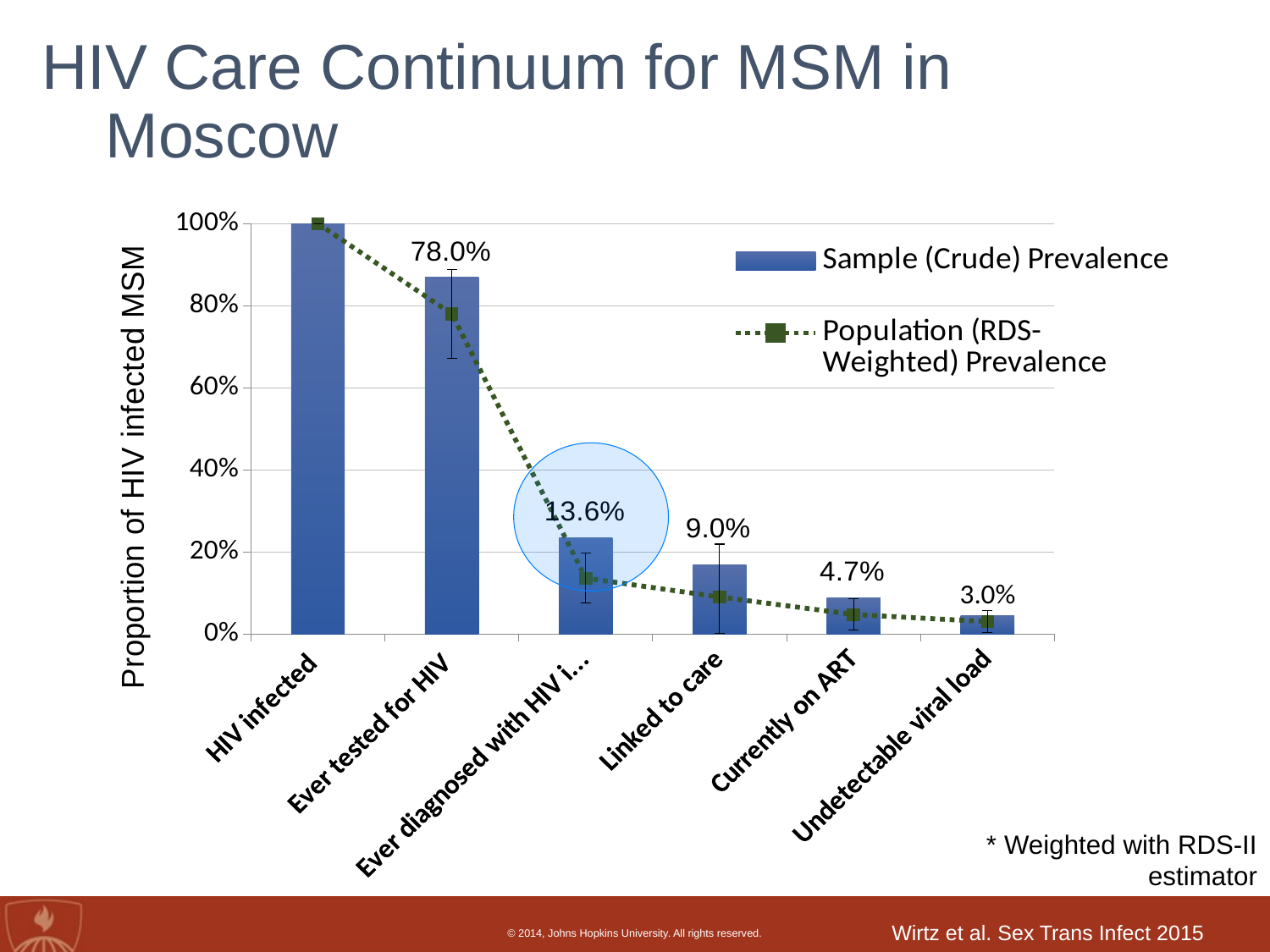
Which category has the highest Sample (Crude) Prevalence? HIV infected What is the Population (RDS-Weighted) Prevalence value for Linked to care? 9.0% What is the Population (RDS-Weighted) Prevalence value for Currently on ART? 4.7% Is the Sample (Crude) Prevalence bar for Linked to care greater or less than 20%? less How many series does the legend list? 2 Which category has the lowest Population (RDS-Weighted) Prevalence? Undetectable viral load How many categories are shown on the x axis? 6 What is the Population (RDS-Weighted) Prevalence value for Undetectable viral load? 3.0% Do the values rise or fall moving from left to right along the x axis? fall What is the Population (RDS-Weighted) Prevalence value for Ever tested for HIV? 78.0% What is the difference between the Population (RDS-Weighted) Prevalence values for Ever tested for HIV and Linked to care? 69.0% Is the Sample (Crude) Prevalence bar for Ever tested for HIV greater or less than 80%? greater